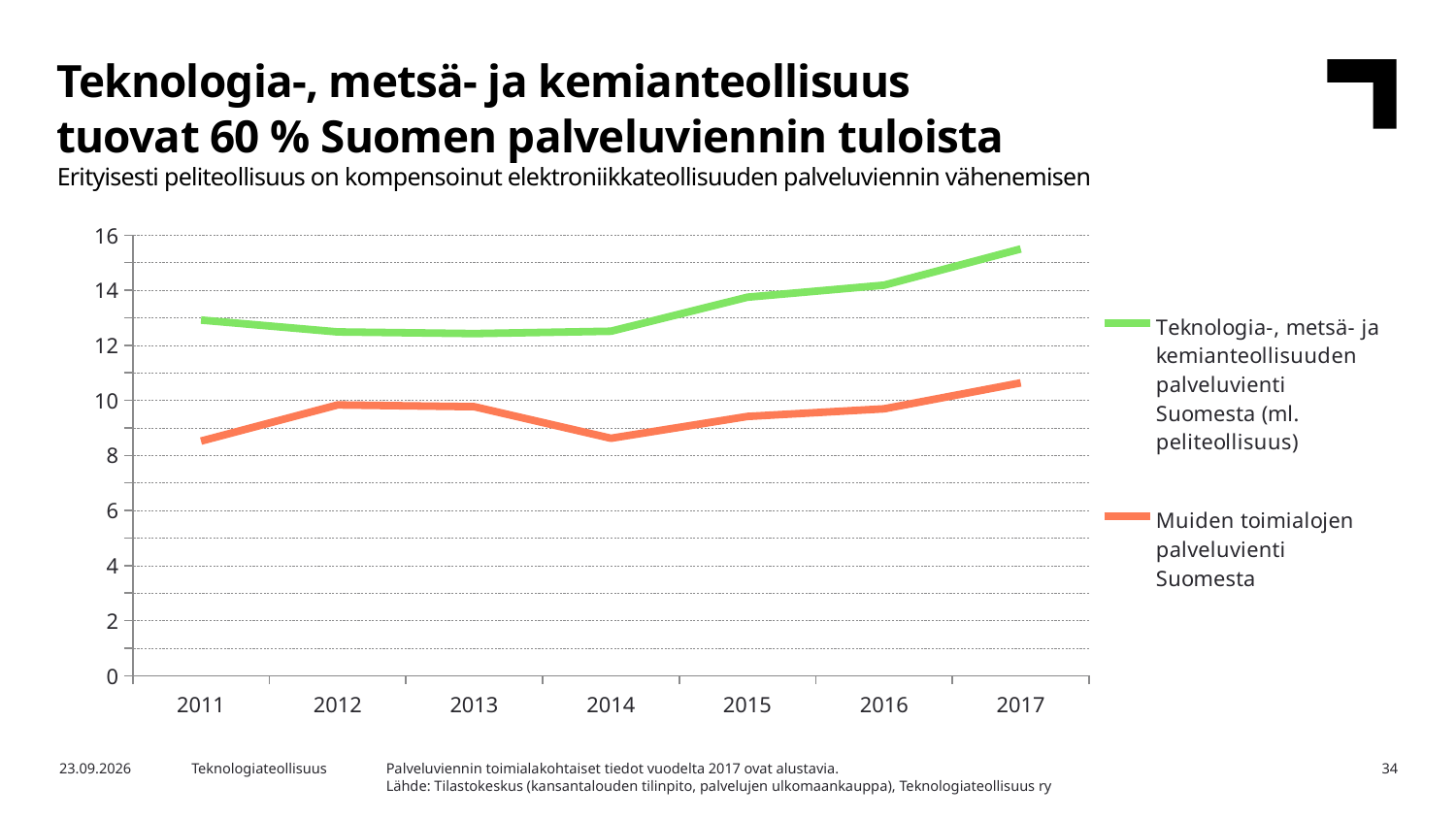
How many years are shown on the x axis? 7 In which year does Muiden toimialojen palveluvienti Suomesta reach its highest value? 2017 Is the value for Muiden toimialojen palveluvienti Suomesta in 2017 greater or less than 10? greater Does the value for Teknologia-, metsä- ja kemianteollisuuden palveluvienti Suomesta rise or fall from 2014 to 2017? Rise Is the value for Teknologia-, metsä- ja kemianteollisuuden palveluvienti Suomesta in 2013 greater or less than 12? greater Which series has the higher value in 2015, Teknologia-, metsä- ja kemianteollisuuden palveluvienti Suomesta or Muiden toimialojen palveluvienti Suomesta? Teknologia-, metsä- ja kemianteollisuuden palveluvienti Suomesta What kind of chart is shown on the slide? Line chart Is the value for Teknologia-, metsä- ja kemianteollisuuden palveluvienti Suomesta in 2017 greater or less than 14? greater In which year does Teknologia-, metsä- ja kemianteollisuuden palveluvienti Suomesta reach its highest value? 2017 Which colour represents Muiden toimialojen palveluvienti Suomesta in the chart? Orange How many series does the legend list? 2